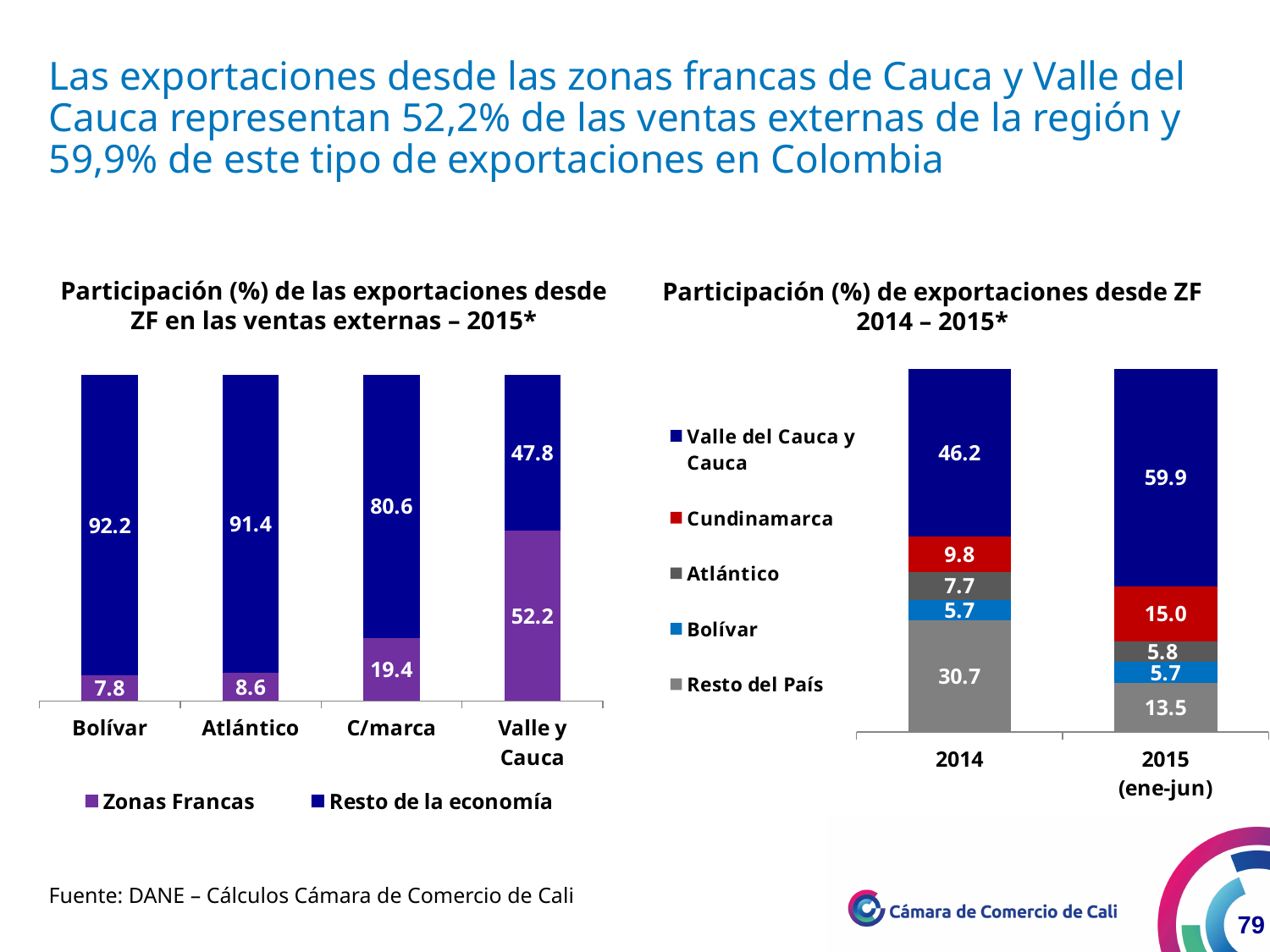
In the right chart, what is the value for Resto del País in 2014? 30.7 In the left chart, what is the difference between the Zonas Francas values for Valle y Cauca and C/marca? 32.8 What type of chart is the right chart? Stacked bar chart In the left chart, how many series does the legend list? 2 In the left chart, which category has the lowest Zonas Francas value? Bolívar In the right chart, how many series does the legend list? 5 In the left chart, which category has the highest Zonas Francas value? Valle y Cauca In the left chart, what is the Resto de la economía value for C/marca? 80.6 In the right chart (Participación (%) de exportaciones desde ZF 2014 – 2015*), what is the value for Valle del Cauca y Cauca in 2015 (ene-jun)? 59.9 In the left chart, how many categories are shown on the x axis? 4 In the left chart (Participación (%) de las exportaciones desde ZF en las ventas externas – 2015*), what is the Zonas Francas value for Bolívar? 7.8 In the right chart, is the Cundinamarca value larger in 2014 or in 2015 (ene-jun)? 2015 (ene-jun)